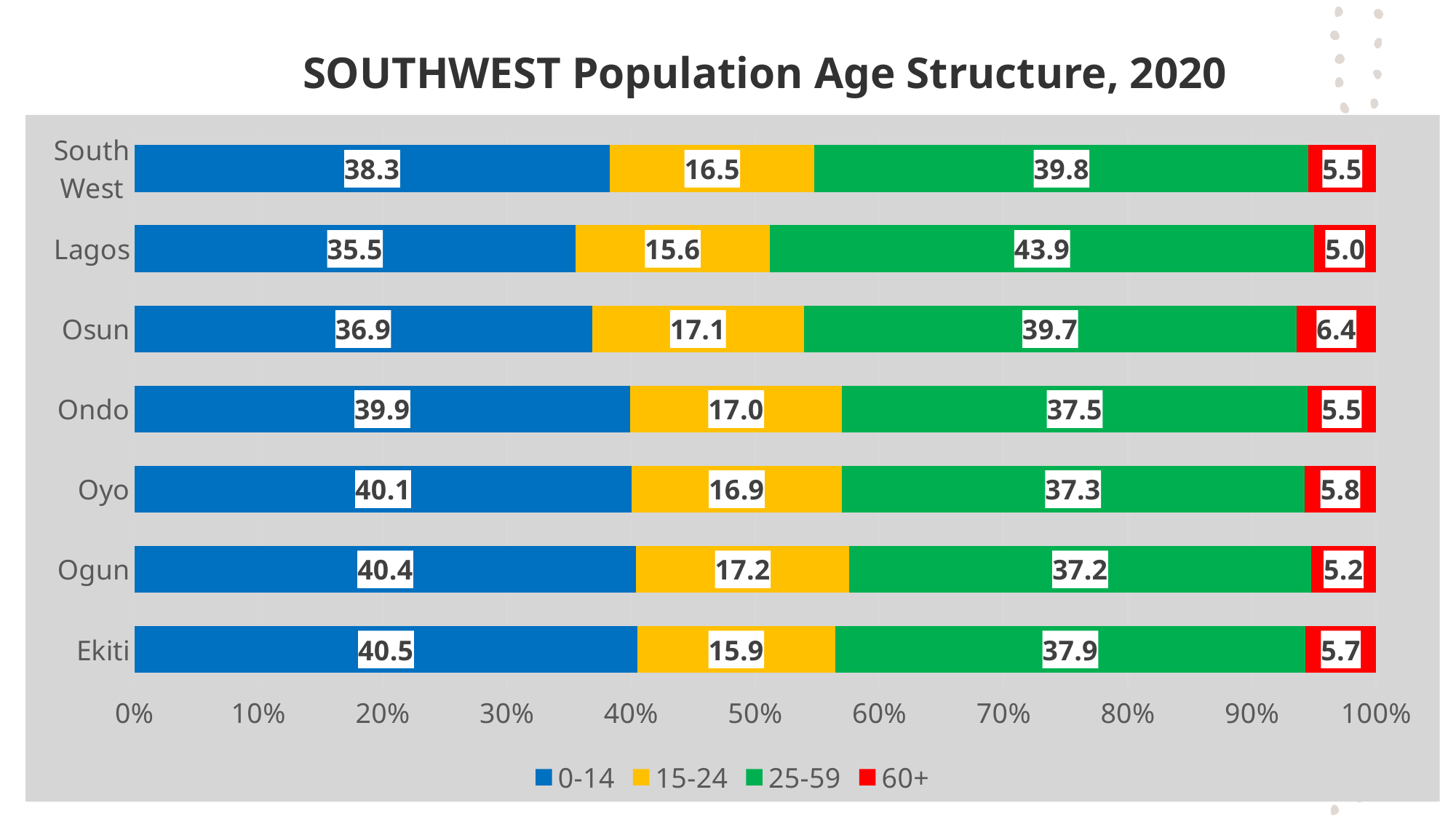
What is the 25-59 value for Osun? 39.7 What is the 60+ value for Oyo? 5.8 How many categories are shown on the y axis? 7 Which is larger, the 0-14 value for Ondo or the 0-14 value for Osun? Ondo Which category has the highest 25-59 value? Lagos How many series does the legend list? 4 What is the difference between the 25-59 values for Lagos and Ekiti? 6.0 Which category has the lowest 0-14 value? Lagos What is the 15-24 value for Ekiti? 15.9 Which category has the highest 60+ value? Osun What is the 0-14 value for Lagos? 35.5 What kind of chart is shown on the slide? Stacked bar chart